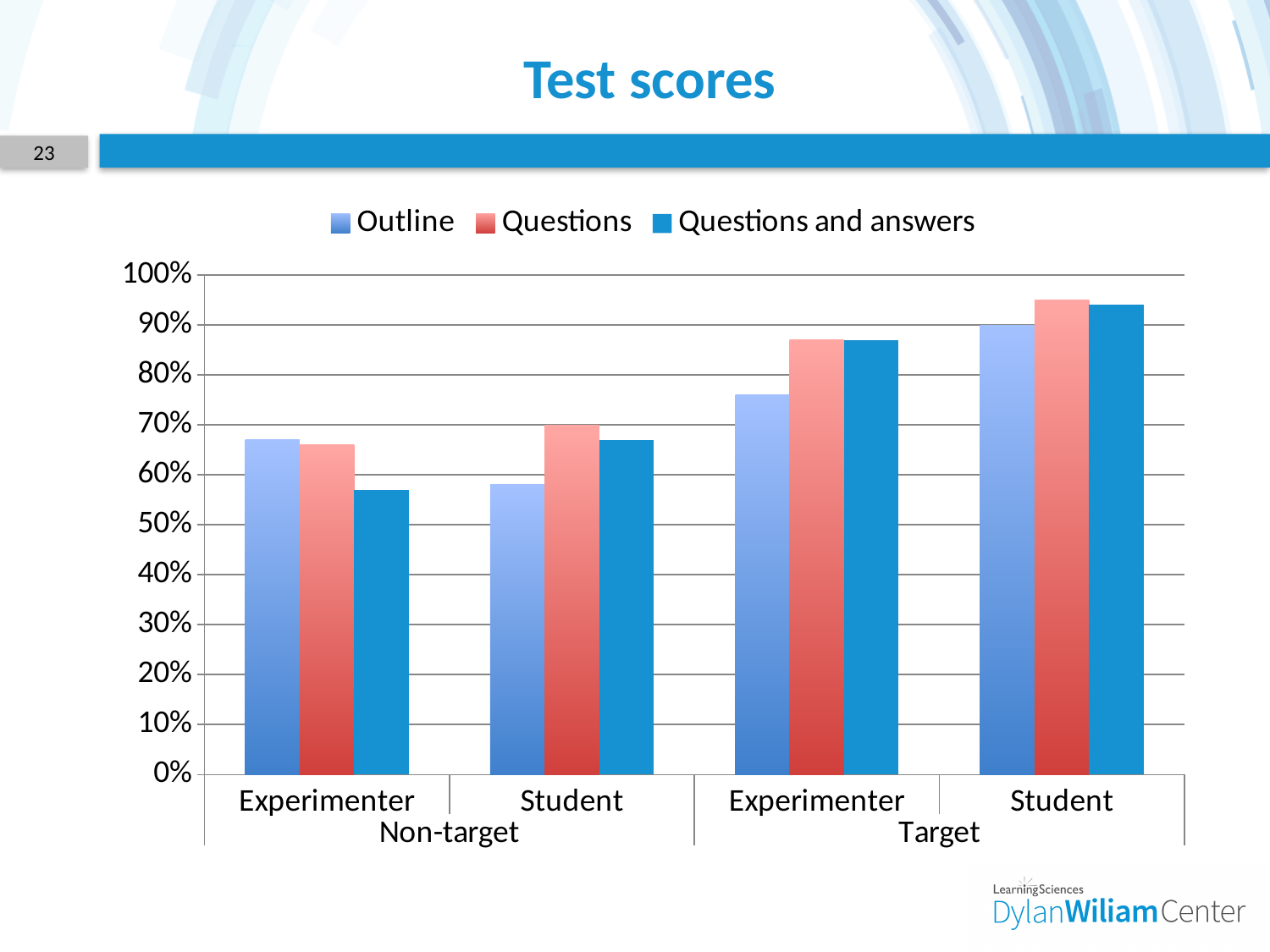
How many series does the legend list? 3 Which category group has the highest Outline value? Target Student How many category groups are shown along the x axis? 4 Is the value for Outline in the Non-target Student group greater or less than 50%? greater Is the value for Outline in the Target Experimenter group greater or less than 80%? less What is the title of the slide? Test scores Is the value for Questions in the Target Student group greater or less than 90%? greater In the Target Experimenter group, which is larger: Outline or Questions? Questions What kind of chart is shown on the slide? bar chart In the Non-target Student group, which is larger: Outline or Questions? Questions Which category group has the lowest Questions and answers value? Non-target Experimenter